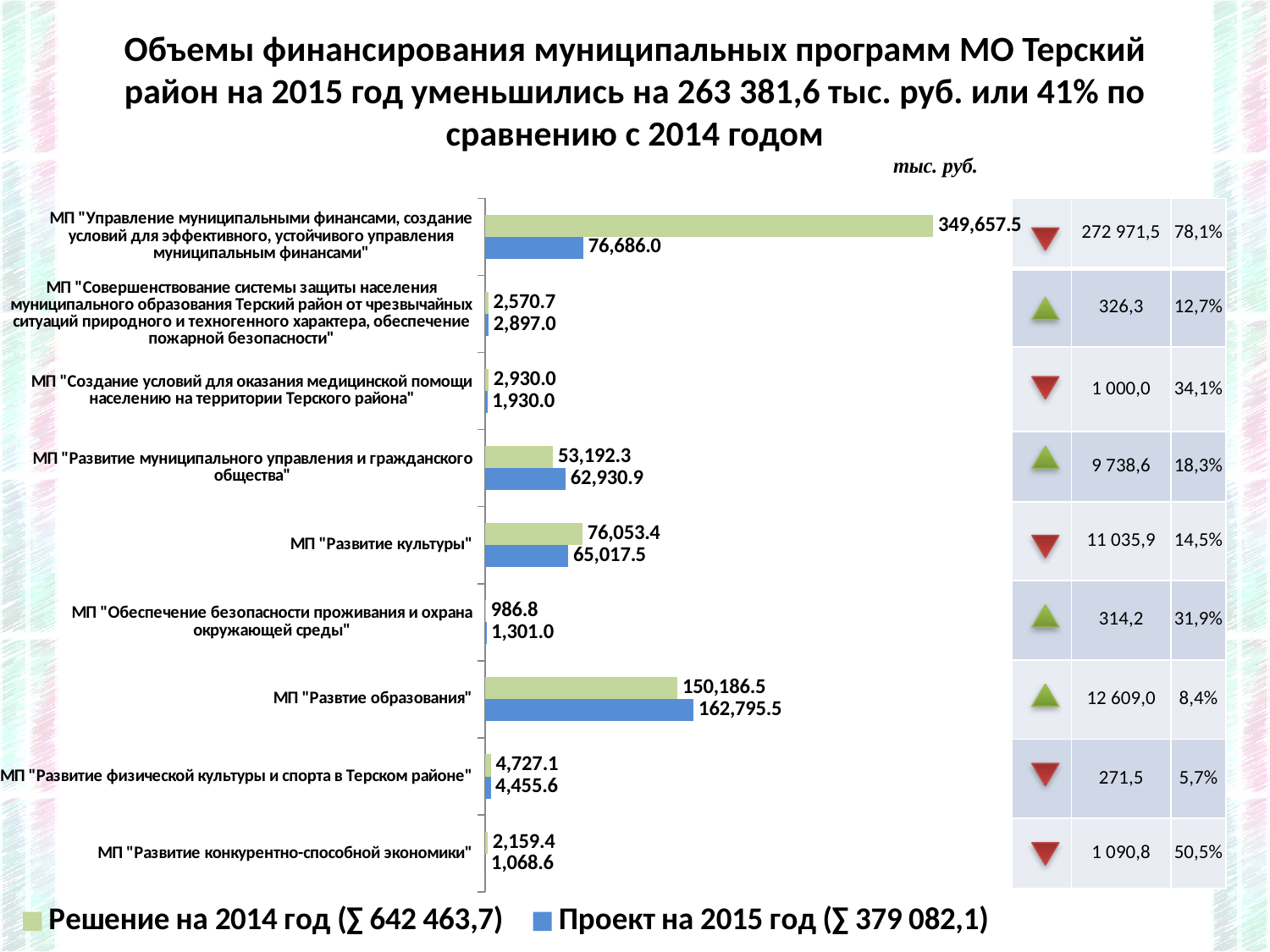
Which category has the lowest value in the series Проект на 2015 год? МП "Развитие конкурентно-способной экономики" For МП "Создание условий для оказания медицинской помощи населению на территории Терского района", which series has the larger value: Решение на 2014 год or Проект на 2015 год? Решение на 2014 год How many series does the legend list? 2 What is the difference between the 2014 and 2015 values for МП "Развитие культуры"? 11,035.9 What kind of chart is shown on the slide? Bar chart Which category has the highest value in the series Решение на 2014 год? МП "Управление муниципальными финансами, создание условий для эффективного, устойчивого управления муниципальным финансами" What is the value for МП "Развитие муниципального управления и гражданского общества" in the series Проект на 2015 год? 62,930.9 What is the value for МП "Развитие культуры" in the series Решение на 2014 год? 76,053.4 What is the difference between the 2015 and 2014 values for МП "Развтие образования"? 12,609.0 How many categories (municipal programmes) are shown on the chart? 9 Which category has the highest value in the series Проект на 2015 год? МП "Развтие образования" What is the value for МП "Развтие образования" in the series Проект на 2015 год? 162,795.5